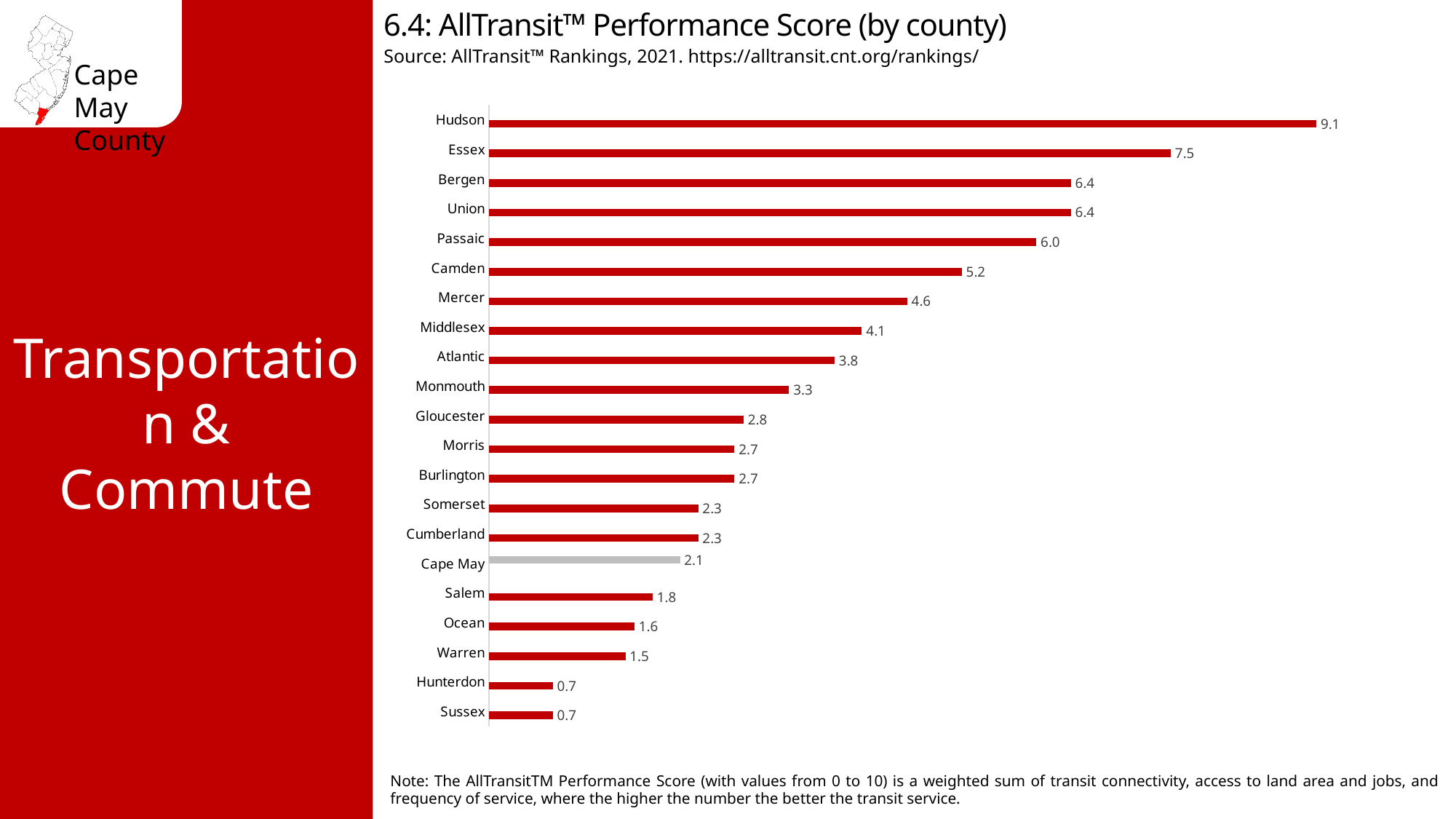
What is the AllTransit Performance Score for Camden county? 5.2 How many counties are shown in the chart? 21 Which county's bar is shown in grey rather than red? Cape May What is the AllTransit Performance Score for Hudson county? 9.1 What is the difference between the AllTransit Performance Scores of Hudson and Essex? 1.6 What type of chart is used to show the AllTransit Performance Score by county? Bar chart What is the difference between the AllTransit Performance Scores of Atlantic and Cape May? 1.7 What is the AllTransit Performance Score for Atlantic county? 3.8 Which county has a higher AllTransit Performance Score, Mercer or Monmouth? Mercer Which county has a higher AllTransit Performance Score, Cape May or Salem? Cape May Which county has the highest AllTransit Performance Score? Hudson What is the AllTransit Performance Score for Cape May county? 2.1